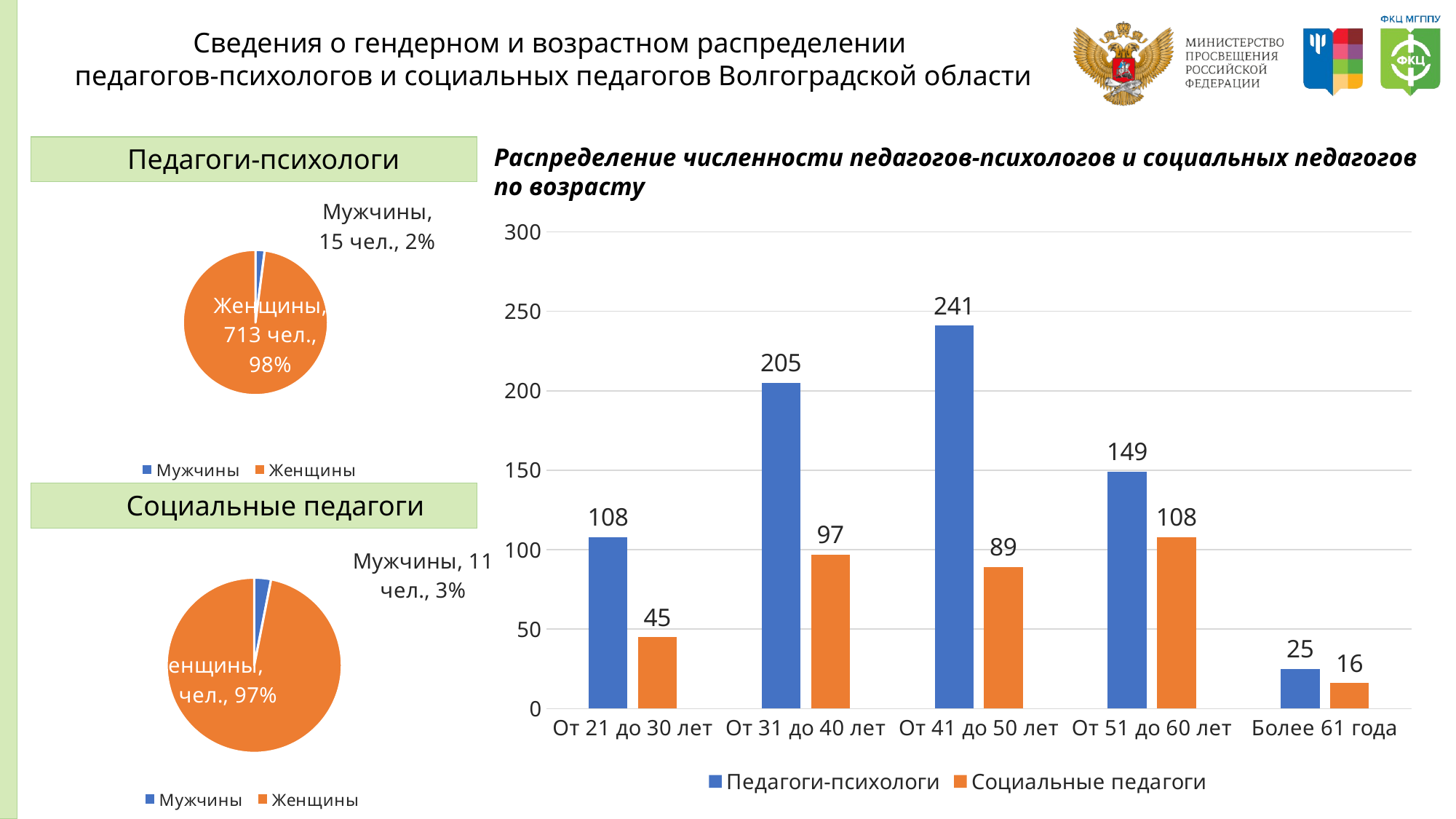
What kind of chart is 'Распределение численности ... по возрасту'? bar chart In the bar chart 'Распределение численности педагогов-психологов и социальных педагогов по возрасту', what is the value for Педагоги-психологи in the 'От 41 до 50 лет' category? 241 In the bar chart 'Распределение численности ... по возрасту', what is the difference between Педагоги-психологи and Социальные педагоги in the 'От 31 до 40 лет' category? 108 In the pie chart 'Социальные педагоги', what share of the pie is the Мужчины slice? 3% How many series does the legend of the bar chart 'Распределение численности ... по возрасту' list? 2 In the pie chart 'Педагоги-психологи', what share of the pie is the Женщины slice? 98% How many age categories are shown in the bar chart 'Распределение численности ... по возрасту'? 5 In the bar chart 'Распределение численности ... по возрасту', which series has the larger value in the 'От 51 до 60 лет' category? Педагоги-психологи In the bar chart 'Распределение численности ... по возрасту', which age category has the lowest value for Социальные педагоги? Более 61 года In the bar chart 'Распределение численности ... по возрасту', which age category has the highest value for Педагоги-психологи? От 41 до 50 лет In the bar chart 'Распределение численности ... по возрасту', what is the value for Социальные педагоги in the 'От 21 до 30 лет' category? 45 In the pie chart 'Педагоги-психологи', how many people are in the Мужчины slice? 15 чел.